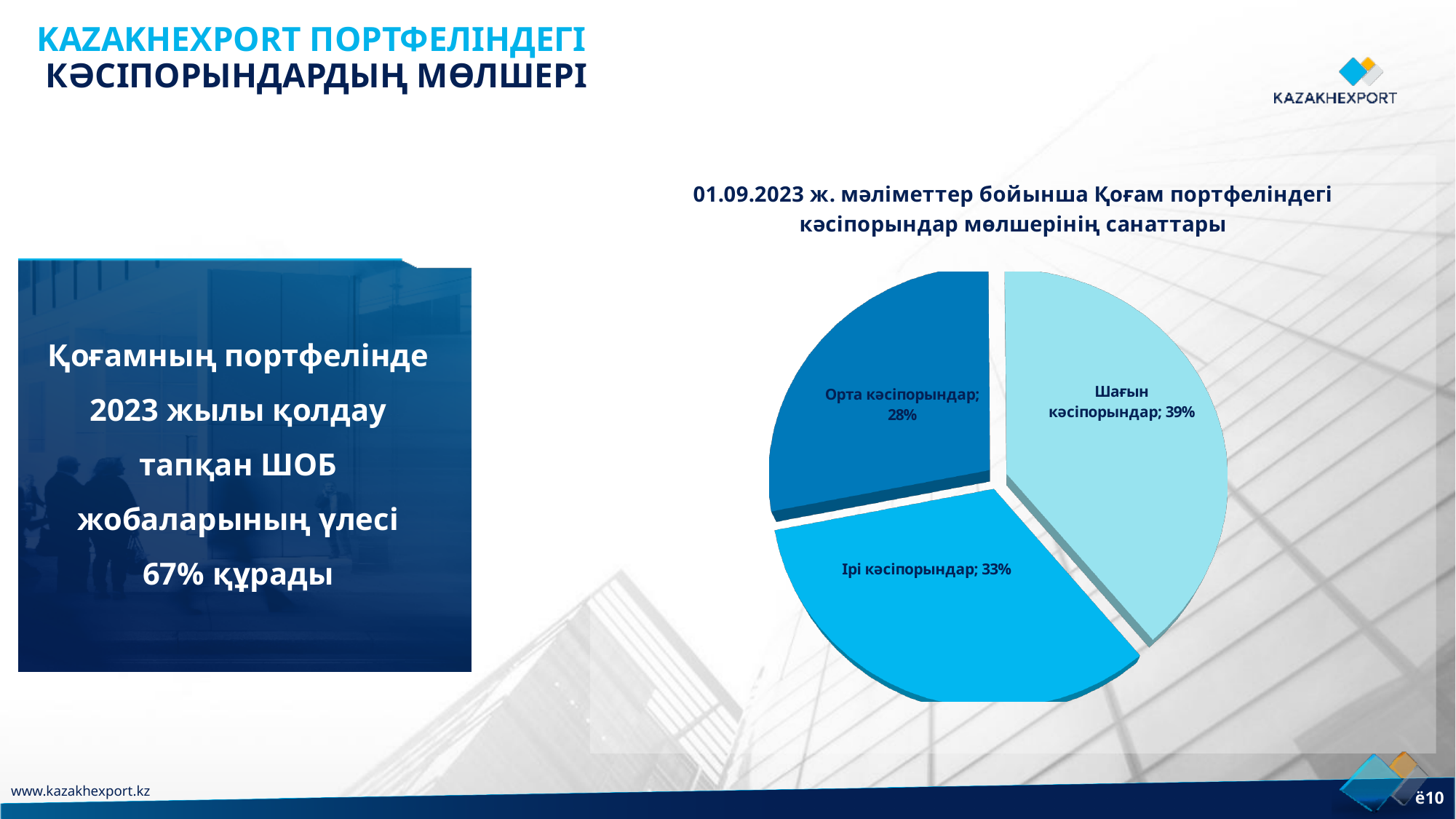
What share of the pie chart is labelled 'Ірі кәсіпорындар'? 33% What date is given in the title of the pie chart? 01.09.2023 How many categories are shown in the pie chart? 3 Which category has the smallest slice in the pie chart? Орта кәсіпорындар What type of chart is shown on the slide? Pie chart What is the difference in percentage points between the 'Ірі кәсіпорындар' slice and the 'Орта кәсіпорындар' slice? 5 Which category has the largest slice in the pie chart? Шағын кәсіпорындар Which slice is larger: 'Ірі кәсіпорындар' or 'Орта кәсіпорындар'? Ірі кәсіпорындар What share of the pie chart is labelled 'Шағын кәсіпорындар'? 39% What is the difference in percentage points between the 'Шағын кәсіпорындар' slice and the 'Орта кәсіпорындар' slice? 11 What is the combined share of 'Шағын кәсіпорындар' and 'Орта кәсіпорындар' in the pie chart? 67% What share of the pie chart is labelled 'Орта кәсіпорындар'? 28%